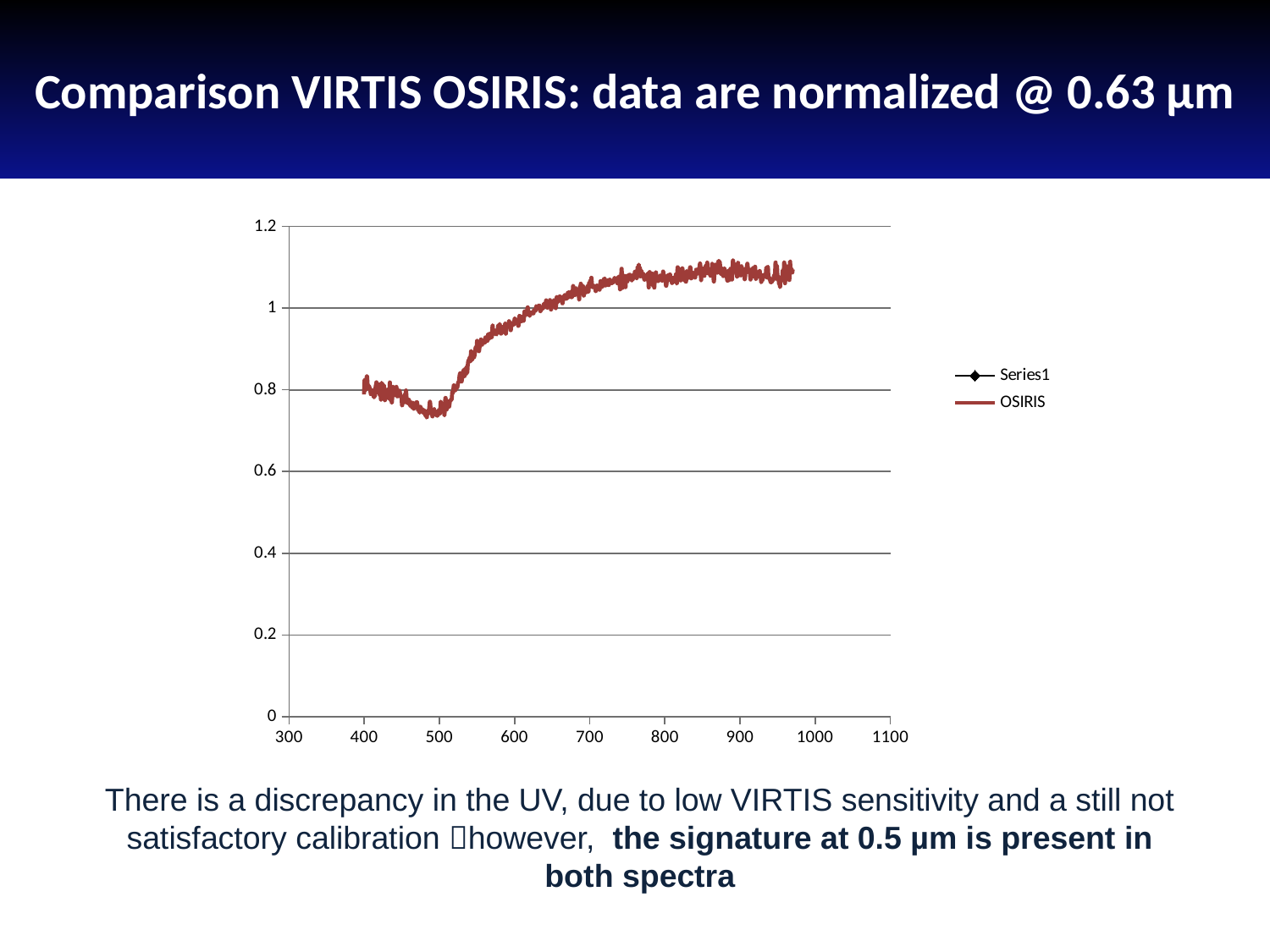
What colour is the OSIRIS line in the chart? red What kind of chart is shown on the slide? line chart What are the two entries in the chart legend? Series1 and OSIRIS Which is larger, the OSIRIS value at x = 900 or at x = 500? x = 900 Is the OSIRIS value at x = 500 greater or less than 0.8? less Is the OSIRIS value at x = 900 greater or less than 1? greater Is the OSIRIS value at x = 400 greater or less than 1? less How many series does the legend list? 2 What is the highest value shown on the y axis? 1.2 Does the OSIRIS curve rise or fall between x = 400 and x = 500? fall Does the OSIRIS curve rise or fall between x = 500 and x = 800? rise